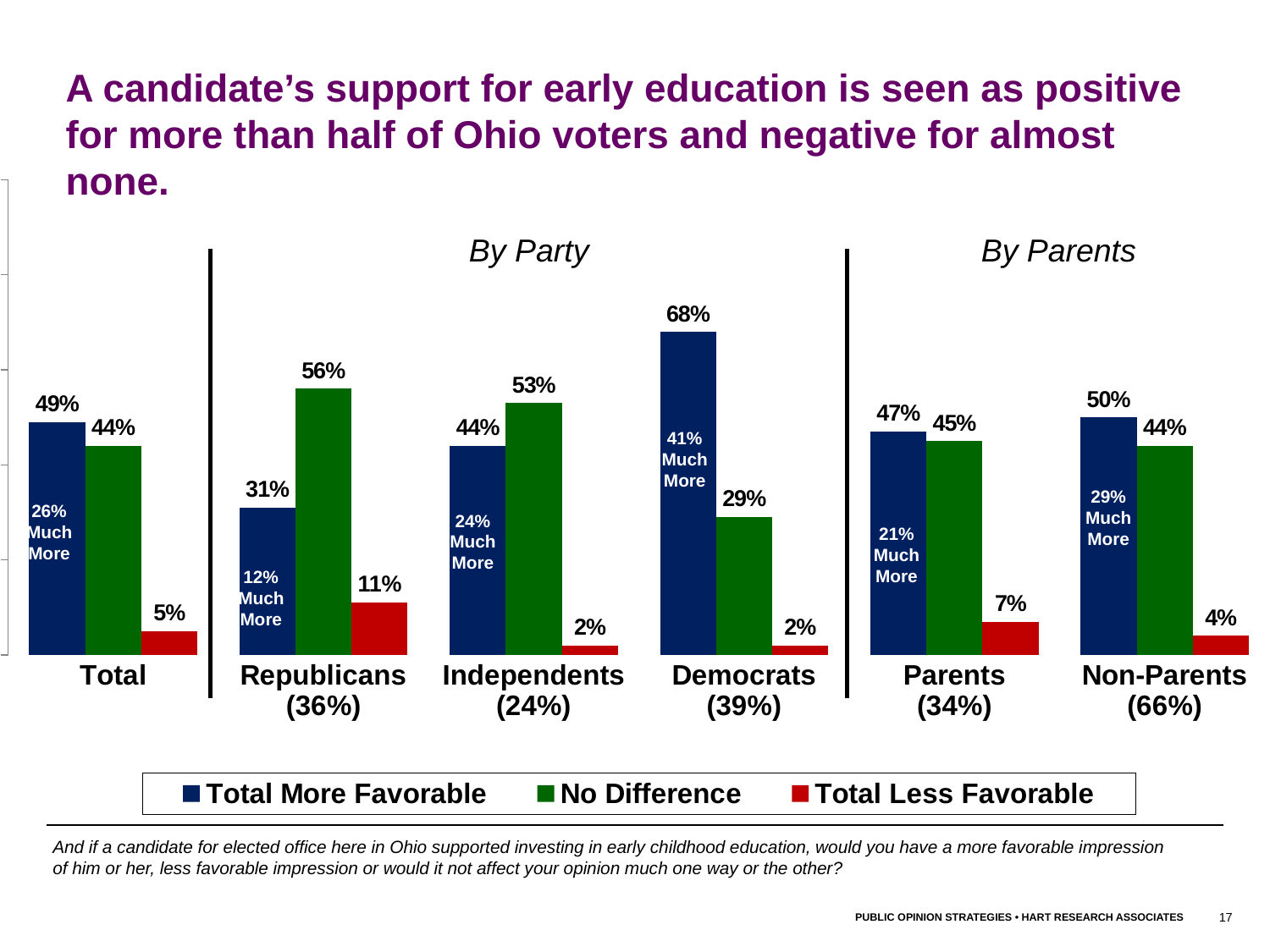
What kind of chart is shown on the slide? Bar chart How many categories are shown along the x axis? 6 What is the No Difference value for Republicans? 56% Which is larger for Independents: Total More Favorable or No Difference? No Difference Which category has the highest Total More Favorable value? Democrats How many series does the legend list? 3 What is the difference between the Total Less Favorable values for Republicans and Democrats? 9 percentage points What is the Total Less Favorable value for Parents? 7% What colour represents the Total Less Favorable series in the legend? Red What is the difference between the Total More Favorable values for Democrats and Republicans? 37 percentage points Which category has the lowest Total More Favorable value? Republicans What percentage of Democrats say they would be more favorable (Total More Favorable)? 68%